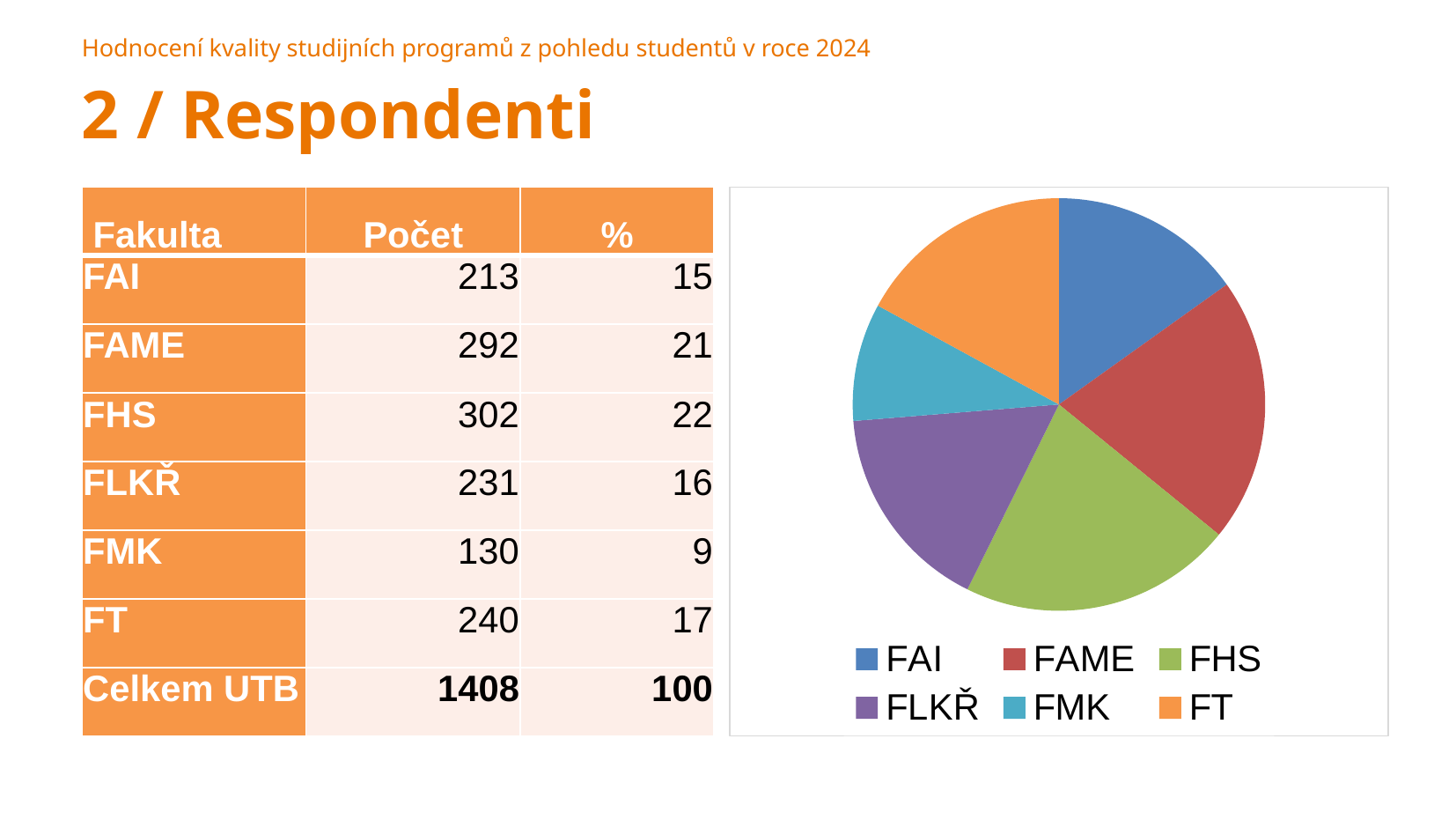
What share of respondents does the FHS slice represent, according to the table? 22 Which faculty has the largest slice in the pie chart? FHS What is the difference in respondent count between FHS and FAI? 89 What share of respondents does the FMK slice represent, according to the table? 9 What is the total number of respondents across all slices (Celkem UTB)? 1408 How many categories (faculties) does the pie chart show? 6 How many respondents does the FAI slice represent (Počet)? 213 What kind of chart is shown on the slide? pie chart Which faculty has the smallest slice in the pie chart? FMK Which colour represents FLKŘ in the pie chart legend? purple Which slice is larger, FT or FMK? FT How many respondents does the FT slice represent (Počet)? 240